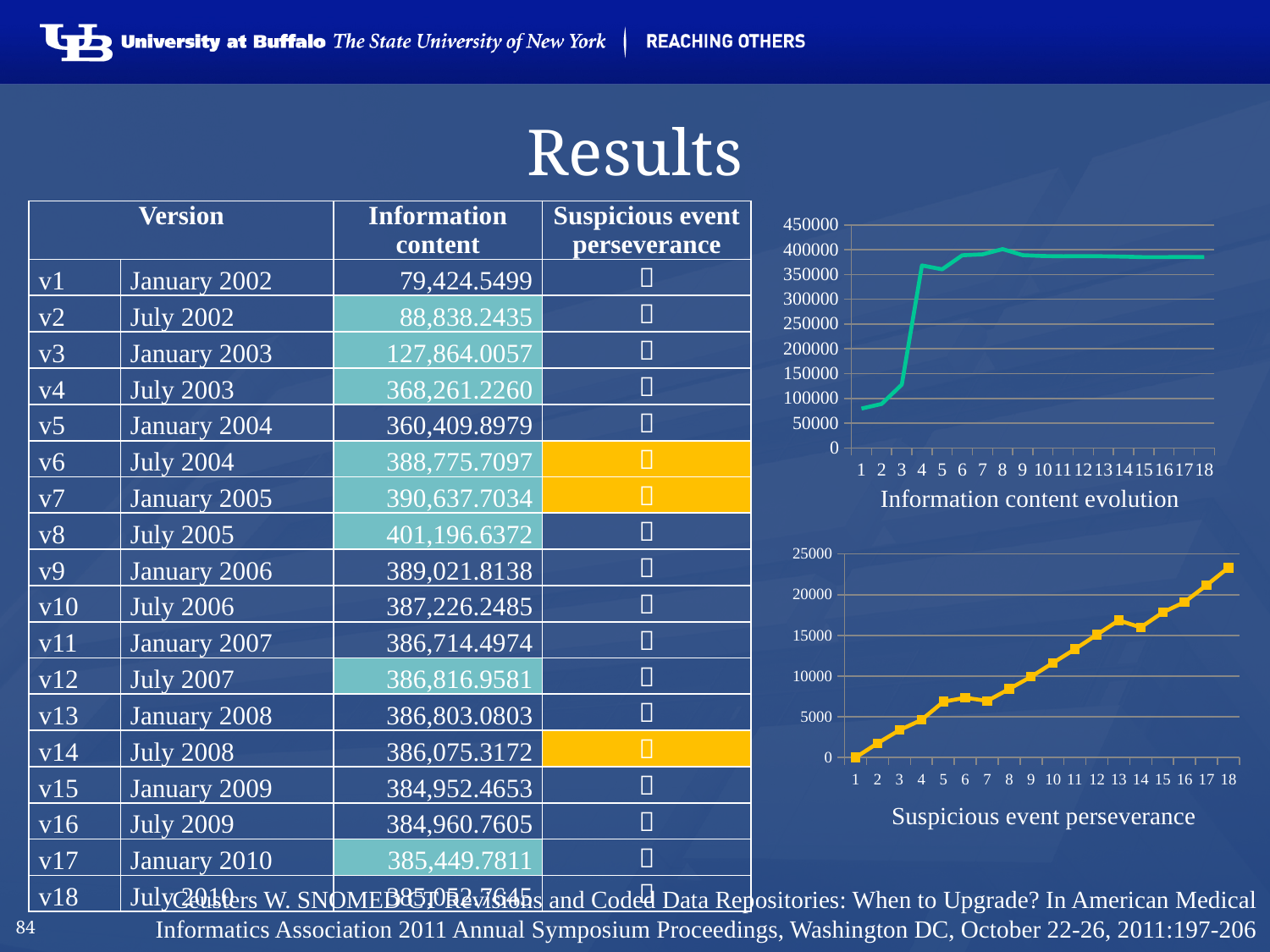
What kind of chart is the 'Suspicious event perseverance' chart? line chart In the 'Information content evolution' chart, is the value at point 4 larger or smaller than the value at point 3? larger In the 'Information content evolution' chart, which x-axis point has the lowest value? 1 In the 'Suspicious event perseverance' chart, how many points are plotted along the x axis? 18 In the 'Suspicious event perseverance' chart, do the values generally rise or fall from point 1 to point 18? rise In the 'Suspicious event perseverance' chart, is the value at point 18 greater or less than 20000? greater In the 'Suspicious event perseverance' chart, is the value at point 13 greater or less than 15000? greater In the 'Suspicious event perseverance' chart, which x-axis point has the highest value? 18 In the 'Information content evolution' chart, is the value at point 3 greater or less than 150000? less What kind of chart is the 'Information content evolution' chart? line chart In the 'Information content evolution' chart, which x-axis point has the highest value? 8 In the 'Information content evolution' chart, how many points are plotted along the x axis? 18